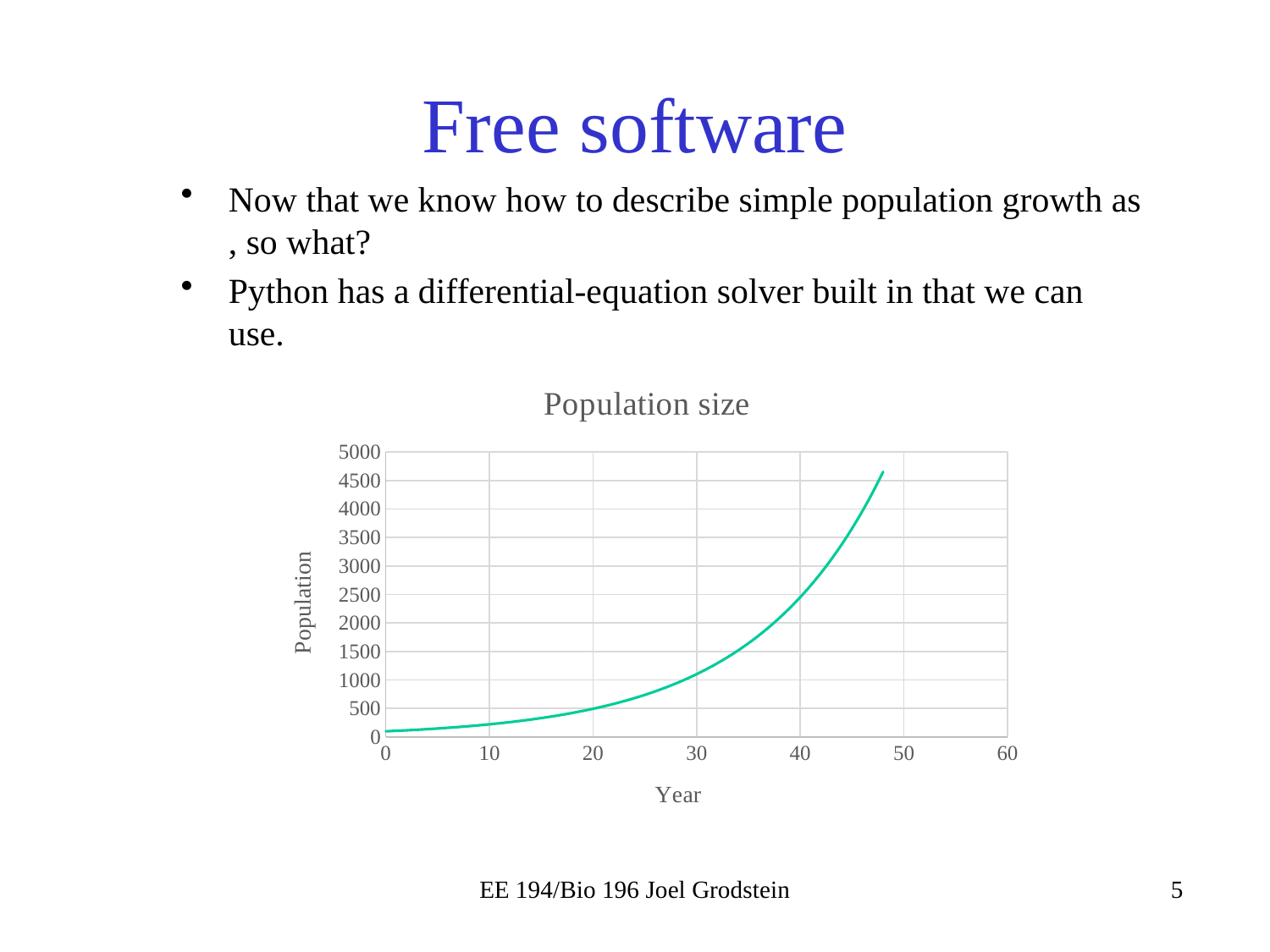
Is the population at the end of the curve (around year 48) greater or less than 4000? greater Is the population at year 40 greater or less than 2000? greater What is the highest value shown on the vertical axis of the chart? 5000 Is the population at year 30 greater or less than 1500? less What is the label on the horizontal axis of the chart? Year Does the population rise or fall as the year increases along the x axis? rise What is the title of the chart? Population size What kind of chart is shown on the slide? line chart Which is larger, the population at year 40 or the population at year 20? year 40